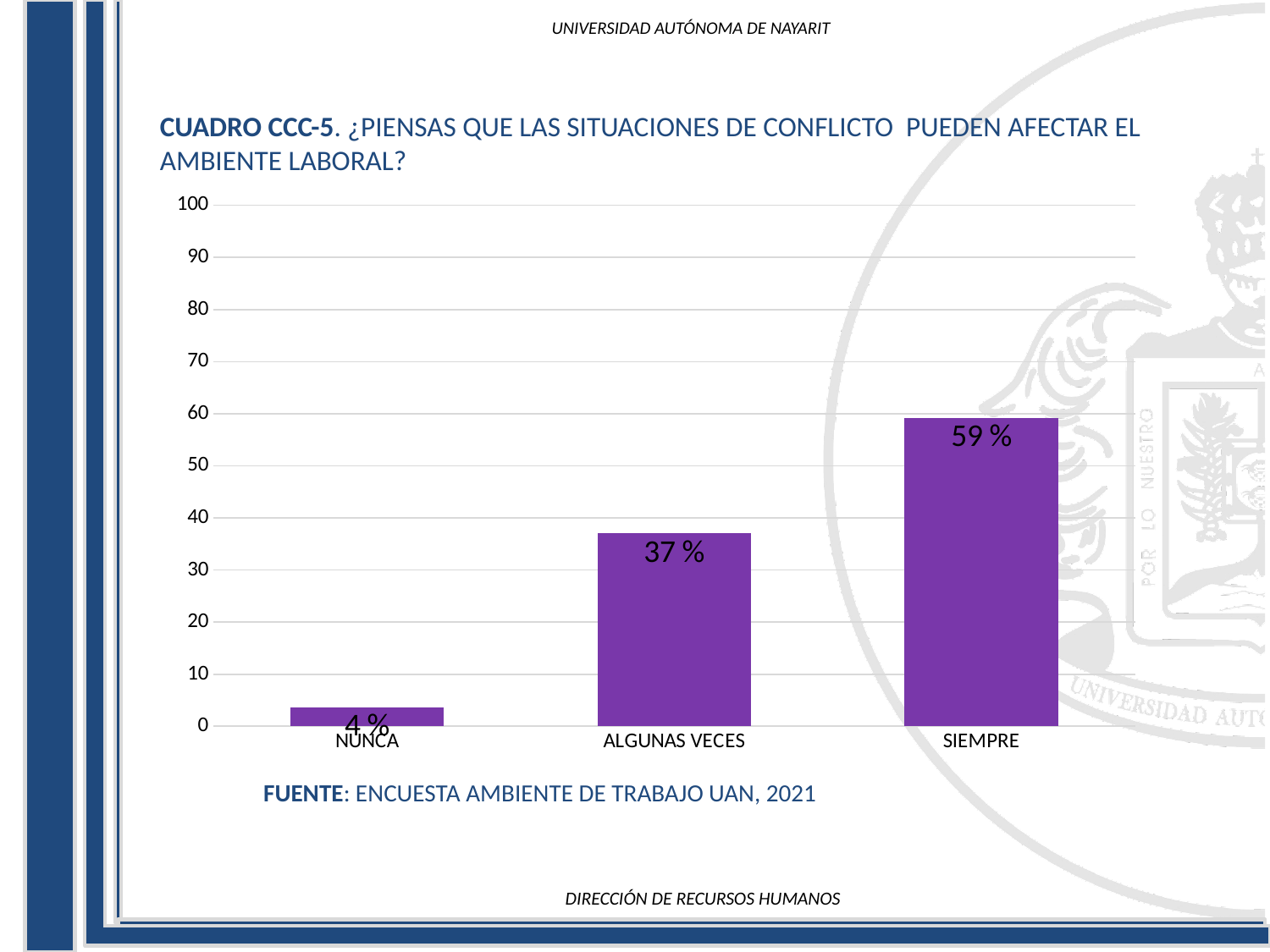
Which category has the lowest value? NUNCA Which category has the highest value? SIEMPRE What kind of chart is shown on the slide? bar chart How many categories are shown on the x axis? 3 What is the value for ALGUNAS VECES? 37 % What is the value for NUNCA? 4 % What source is cited below the chart? ENCUESTA AMBIENTE DE TRABAJO UAN, 2021 What is the value for SIEMPRE? 59 % Do the values rise or fall from NUNCA to SIEMPRE along the x axis? rise Which is larger, the value for ALGUNAS VECES or the value for NUNCA? ALGUNAS VECES What is the difference between the values for SIEMPRE and ALGUNAS VECES? 22 % Is the value for ALGUNAS VECES greater or less than 40? less